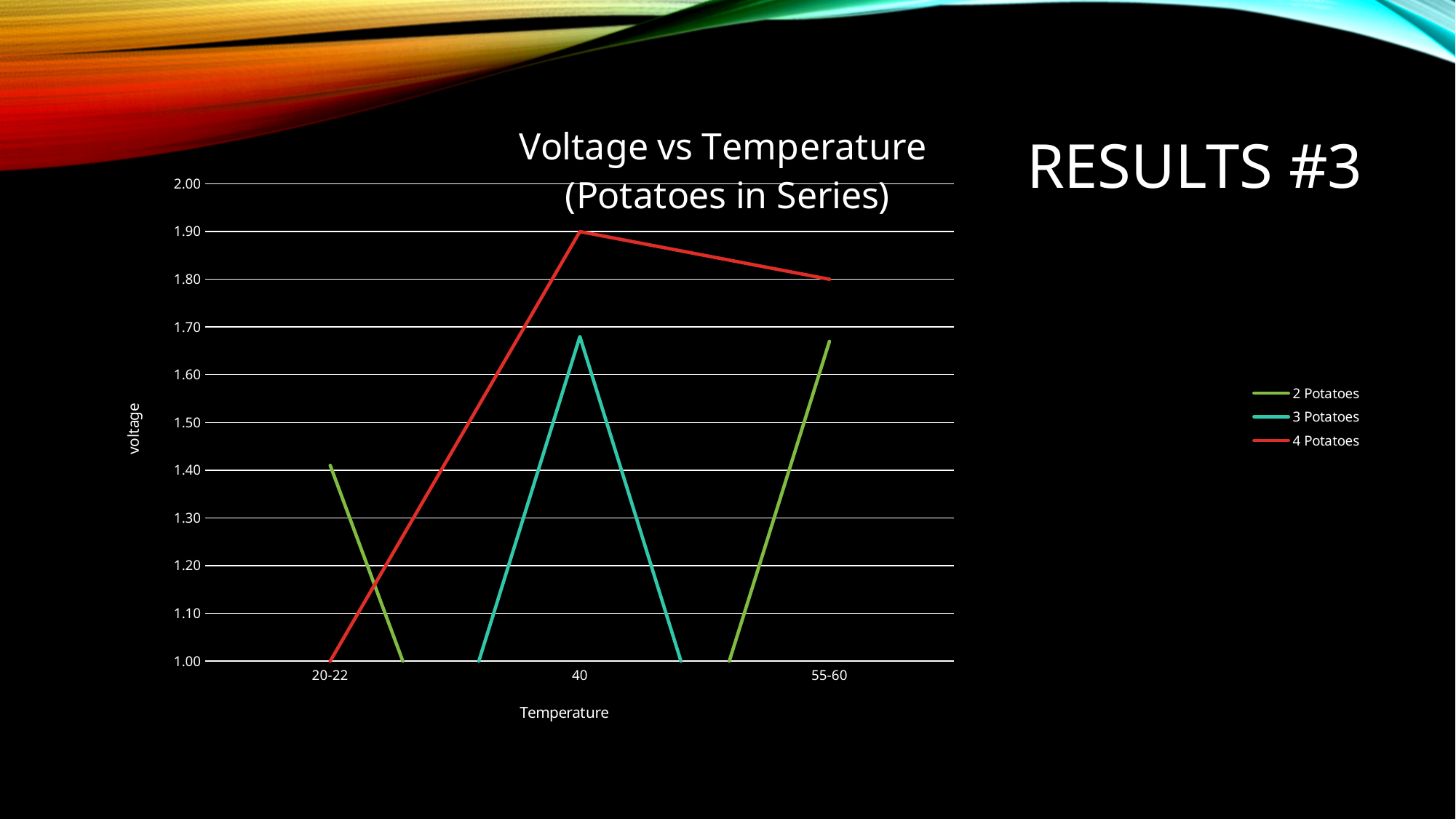
What is the voltage for 4 Potatoes at temperature 40? 1.90 Does the 4 Potatoes line rise or fall from temperature 40 to 55-60? fall Is the voltage for 3 Potatoes at temperature 40 greater or less than 1.60? greater How many series does the legend list? 3 How many temperature categories are shown on the x axis? 3 What is the voltage for 4 Potatoes at temperature 55-60? 1.80 Which is larger at temperature 55-60: the voltage for 4 Potatoes or for 2 Potatoes? 4 Potatoes What kind of chart is shown on the slide? line chart What is the difference between the 4 Potatoes voltage at 40 and at 55-60? 0.10 Is the voltage for 2 Potatoes at temperature 20-22 greater or less than 1.30? greater Which series has the highest voltage at temperature 40? 4 Potatoes What is the title of the chart? Voltage vs Temperature (Potatoes in Series)